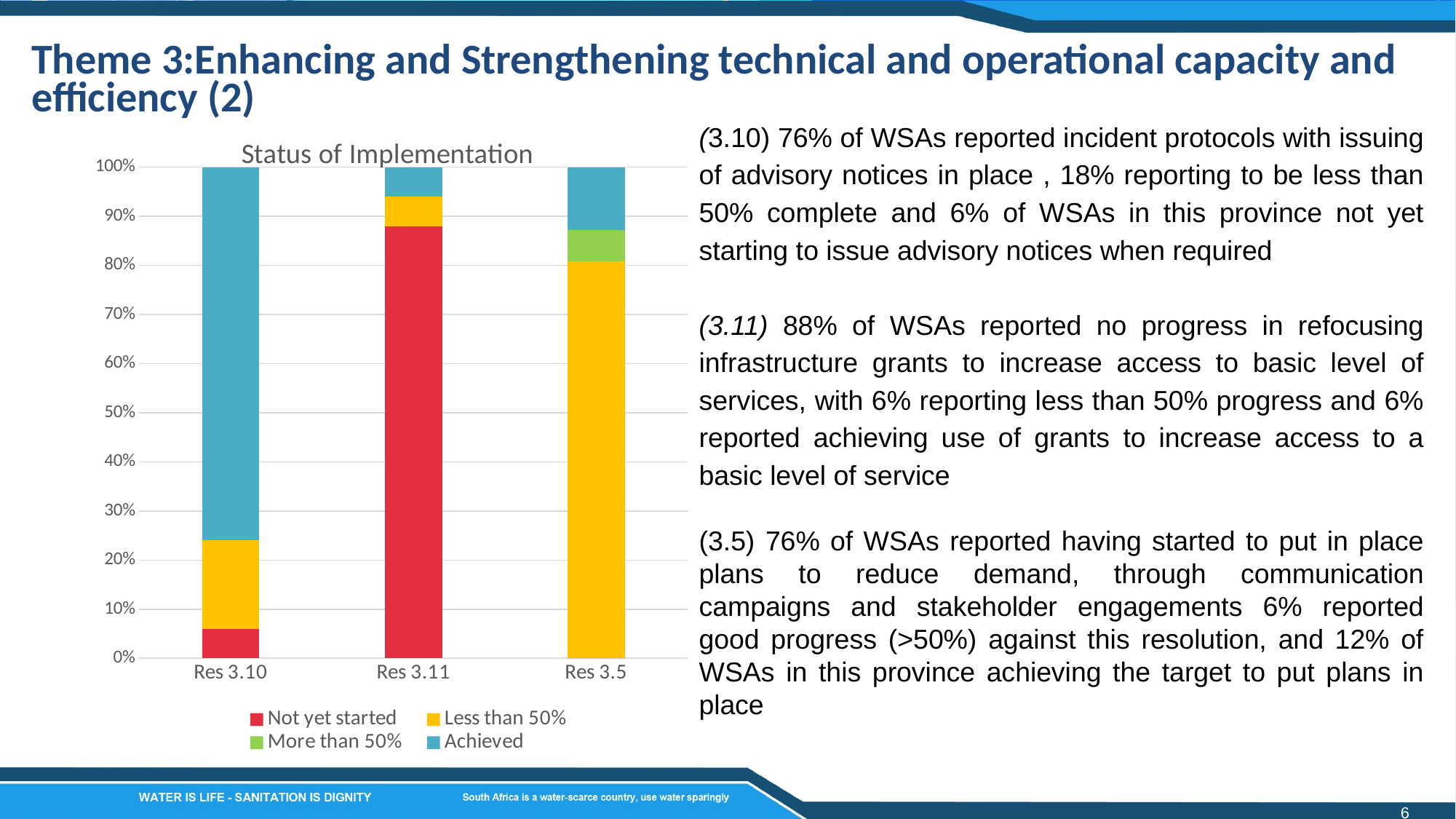
What kind of chart is shown on the slide? Stacked bar chart Is the 'Achieved' value for Res 3.10 greater or less than 70%? greater Is the 'Less than 50%' value for Res 3.5 greater or less than 70%? greater Is the 'Not yet started' value for Res 3.11 greater or less than 80%? greater What is the title of the chart? Status of Implementation Which has the larger 'Not yet started' segment, Res 3.10 or Res 3.11? Res 3.11 Which category has the smallest 'Not yet started' segment? Res 3.5 What is the total of the stacked bar for Res 3.10? 100% How many categories are shown on the x axis of the chart? 3 How many series does the chart legend list? 4 Which has the larger 'Achieved' segment, Res 3.10 or Res 3.11? Res 3.10